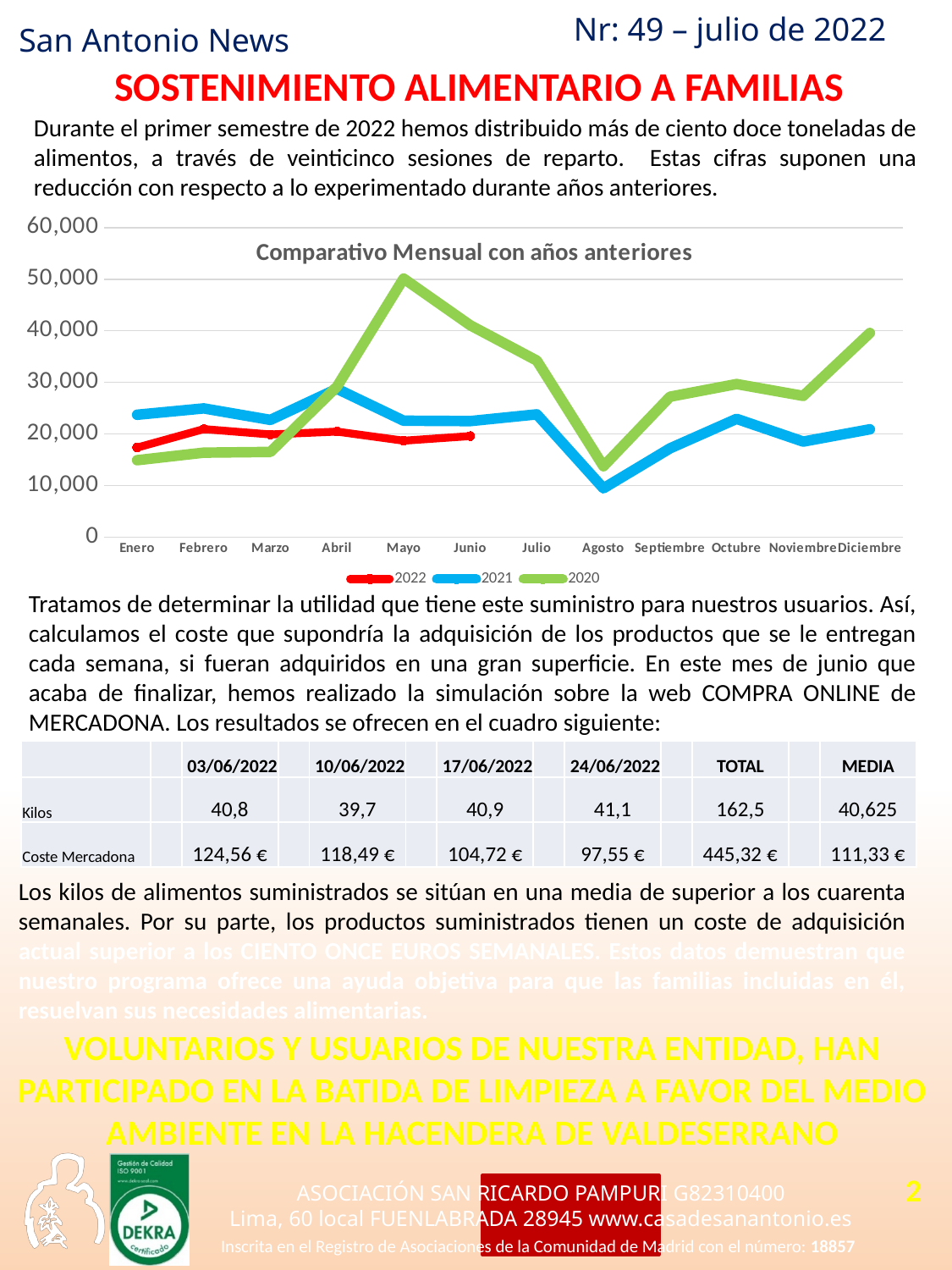
In which month does the 2020 series reach its highest value? Mayo Is the value for 2020 in Diciembre greater or less than 30,000? greater How many series does the chart legend list? 3 In Enero, which series has the larger value, 2020 or 2021? 2021 What is the title of the chart? Comparativo Mensual con años anteriores How many months are shown on the x axis of the chart? 12 In Abril, which series has the larger value, 2021 or 2022? 2021 In which month does the 2021 series reach its lowest value? Agosto What kind of chart is shown on the slide? Line chart Is the value for 2022 in Enero greater or less than 20,000? less Does the 2021 series rise or fall from Abril to Agosto? Fall Is the value for 2020 in Mayo greater or less than 40,000? greater